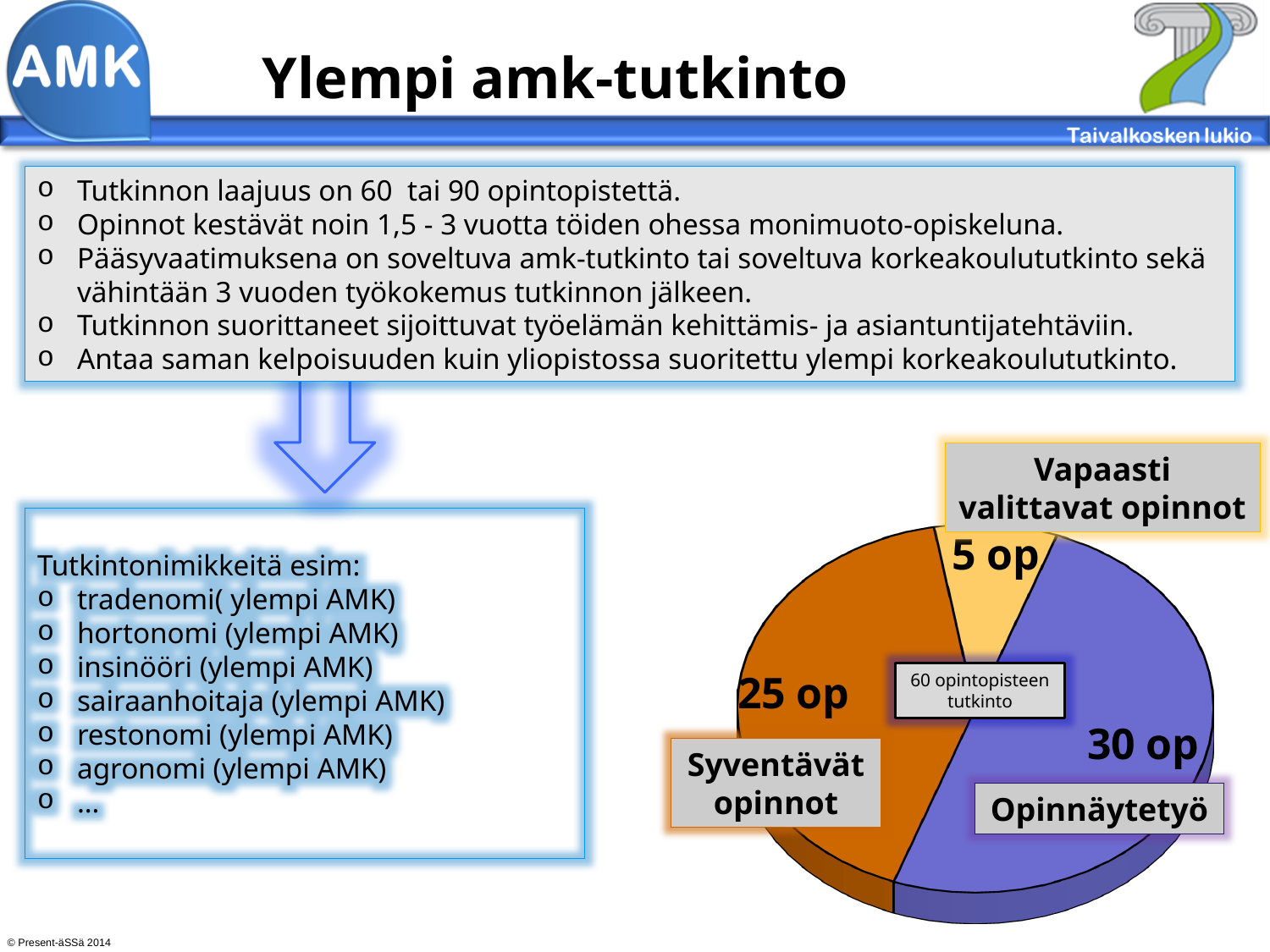
What is the value of the Vapaasti valittavat opinnot slice in the pie chart? 5 op What colour is the Syventävät opinnot slice in the pie chart? orange What is the value of the Opinnäytetyö slice in the pie chart? 30 op What is the value of the Syventävät opinnot slice in the pie chart? 25 op What is the difference between the Opinnäytetyö and Syventävät opinnot slices? 5 op What is the total of all slices in the pie chart? 60 op What kind of chart is shown on the slide? pie chart Which slice of the pie chart is the smallest? Vapaasti valittavat opinnot Which slice of the pie chart is the largest? Opinnäytetyö How many slices does the pie chart have? 3 Which is larger in the pie chart, Syventävät opinnot or Vapaasti valittavat opinnot? Syventävät opinnot What share of the pie does the Opinnäytetyö slice represent? 50%